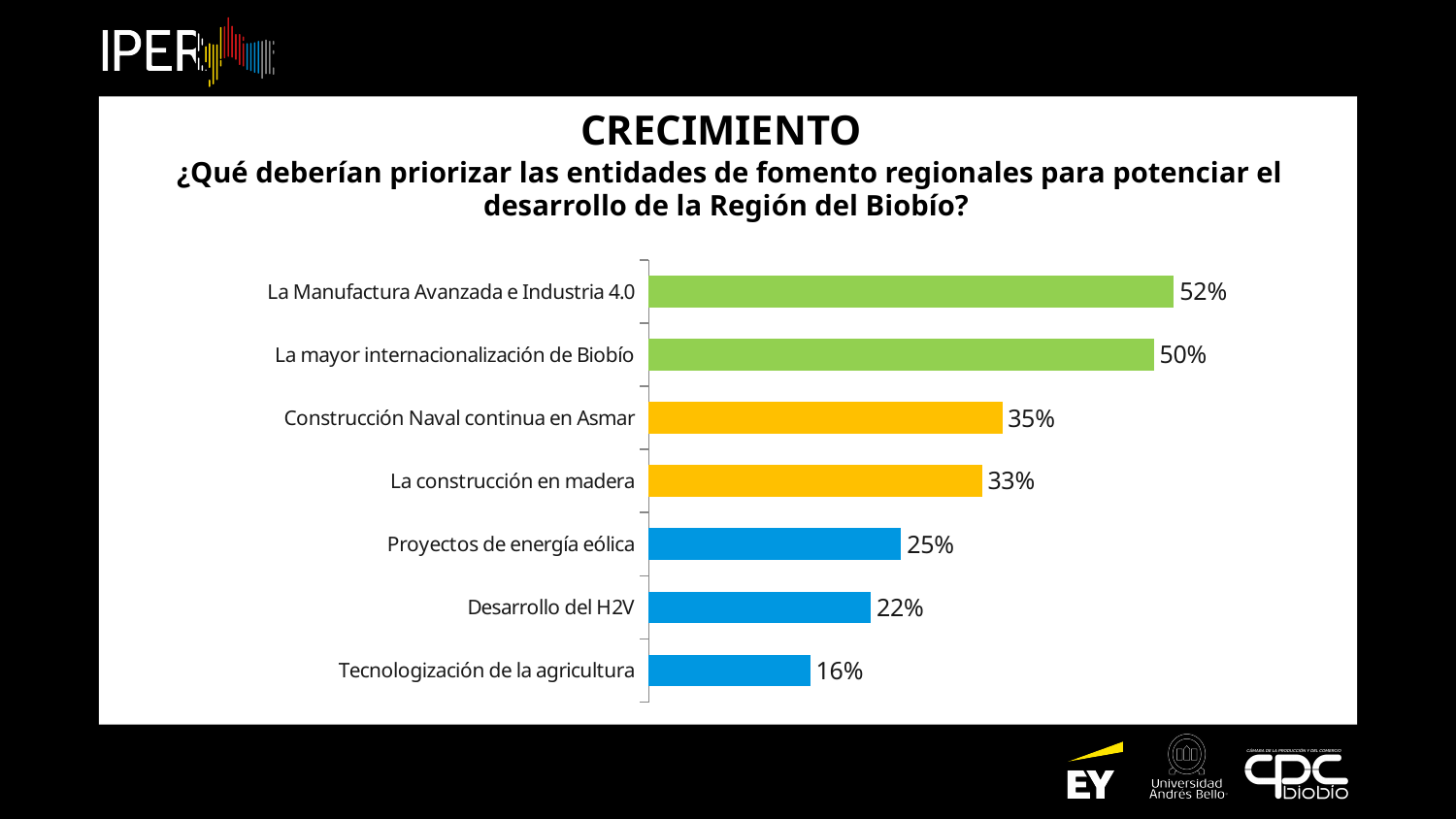
Which category has the highest value? La Manufactura Avanzada e Industria 4.0 What is the value for Construcción Naval continua en Asmar? 35% How many categories are shown in the chart? 7 What is the difference between La mayor internacionalización de Biobío and Proyectos de energía eólica? 25% What kind of chart is shown on the slide? Bar chart Which category has the lowest value? Tecnologización de la agricultura What is the title shown above the chart? CRECIMIENTO What is the difference between Construcción Naval continua en Asmar and La construcción en madera? 2% What is the value for Desarrollo del H2V? 22% What colour are the bars for Proyectos de energía eólica, Desarrollo del H2V and Tecnologización de la agricultura? Blue Which is larger, Proyectos de energía eólica or Tecnologización de la agricultura? Proyectos de energía eólica What is the value for La Manufactura Avanzada e Industria 4.0? 52%